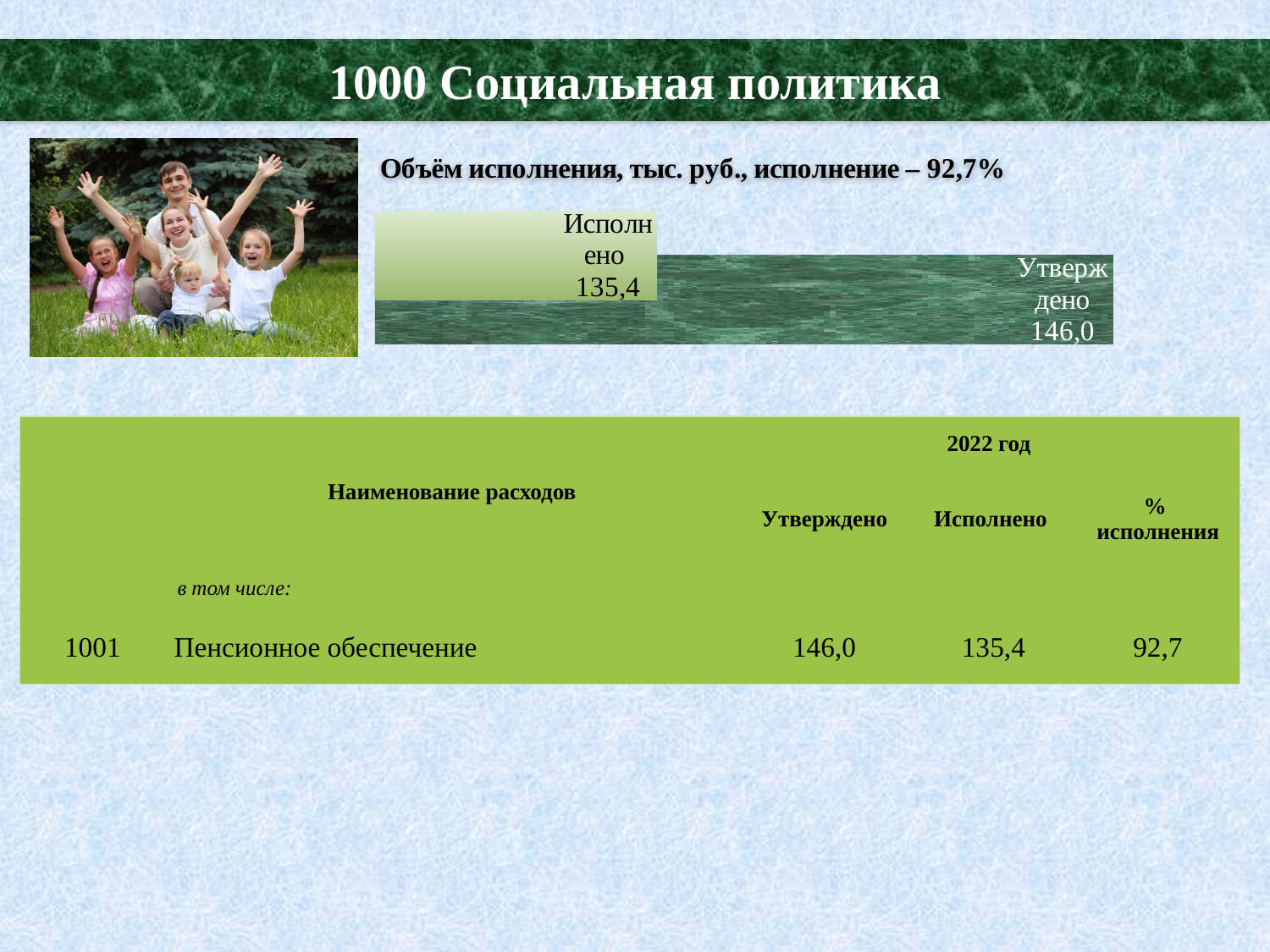
What execution percentage is stated in the chart title? 92,7% What is the title of the chart on the slide? Объём исполнения, тыс. руб., исполнение – 92,7% Which category in the chart has the highest value? Утверждено What is the value shown for Утверждено in the chart? 146,0 Which category in the chart has the lowest value? Исполнено What type of chart is shown on the slide? bar chart Which bar in the chart has the higher value, Утверждено or Исполнено? Утверждено What is the value shown for Исполнено in the chart? 135,4 What is the difference between the Утверждено and Исполнено values in the chart? 10,6 How many bars are plotted in the chart? 2